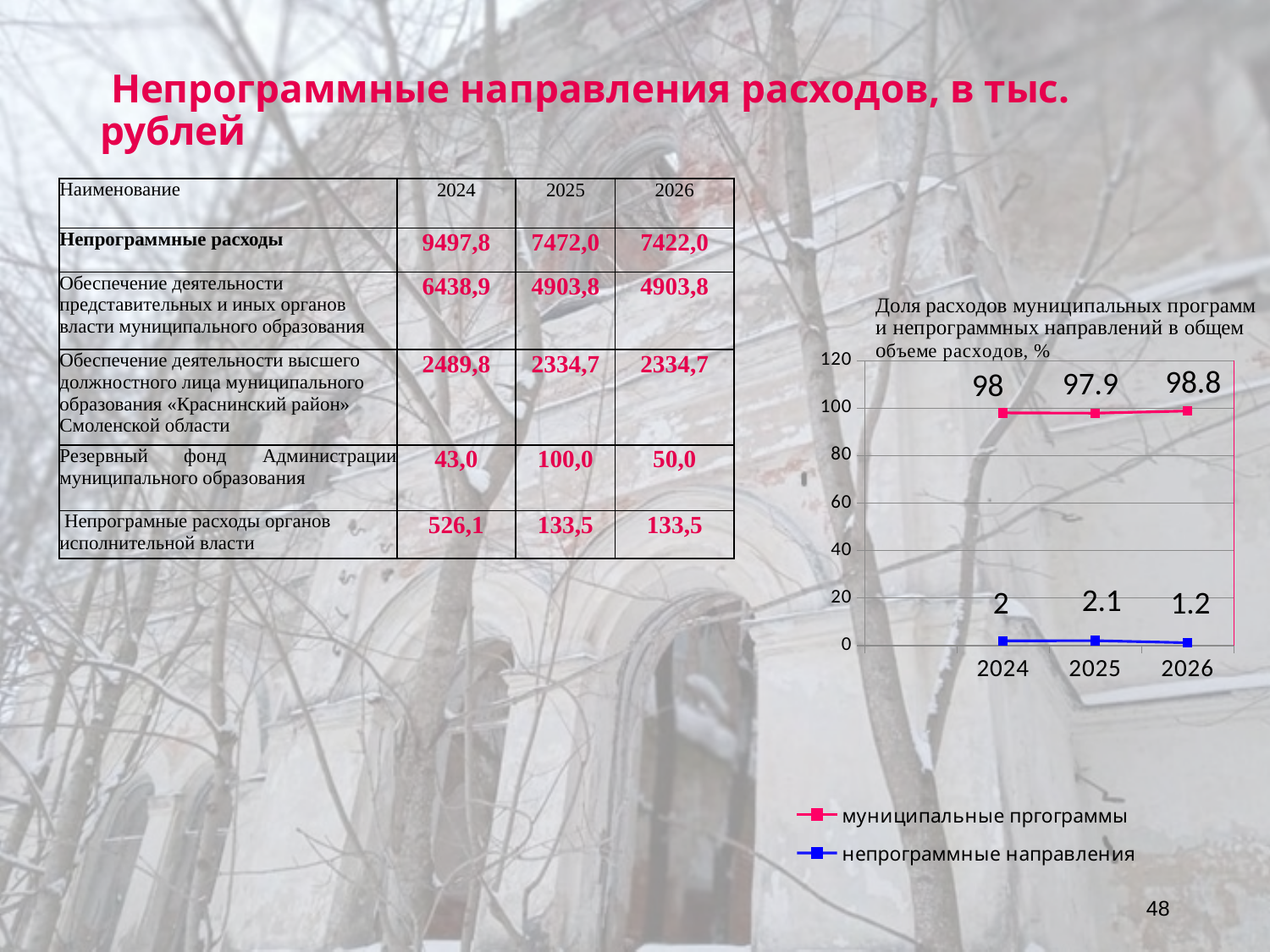
Which series has the larger value in 2024, муниципальные программы or непрограммные направления? муниципальные программы What is the value for непрограммные направления in 2025? 2.1 How many series does the chart legend list? 2 What is the value for непрограммные направления in 2026? 1.2 What is the total of the two series' values for 2024? 100 How many years are plotted on the x axis of the chart? 3 What is the value for муниципальные программы in 2024? 98 What is the difference between the муниципальные программы values for 2026 and 2025? 0.9 What type of chart is shown on the slide? line chart What is the value for муниципальные программы in 2025? 97.9 In which year is the value for непрограммные направления lowest? 2026 In which year is the value for муниципальные программы highest? 2026